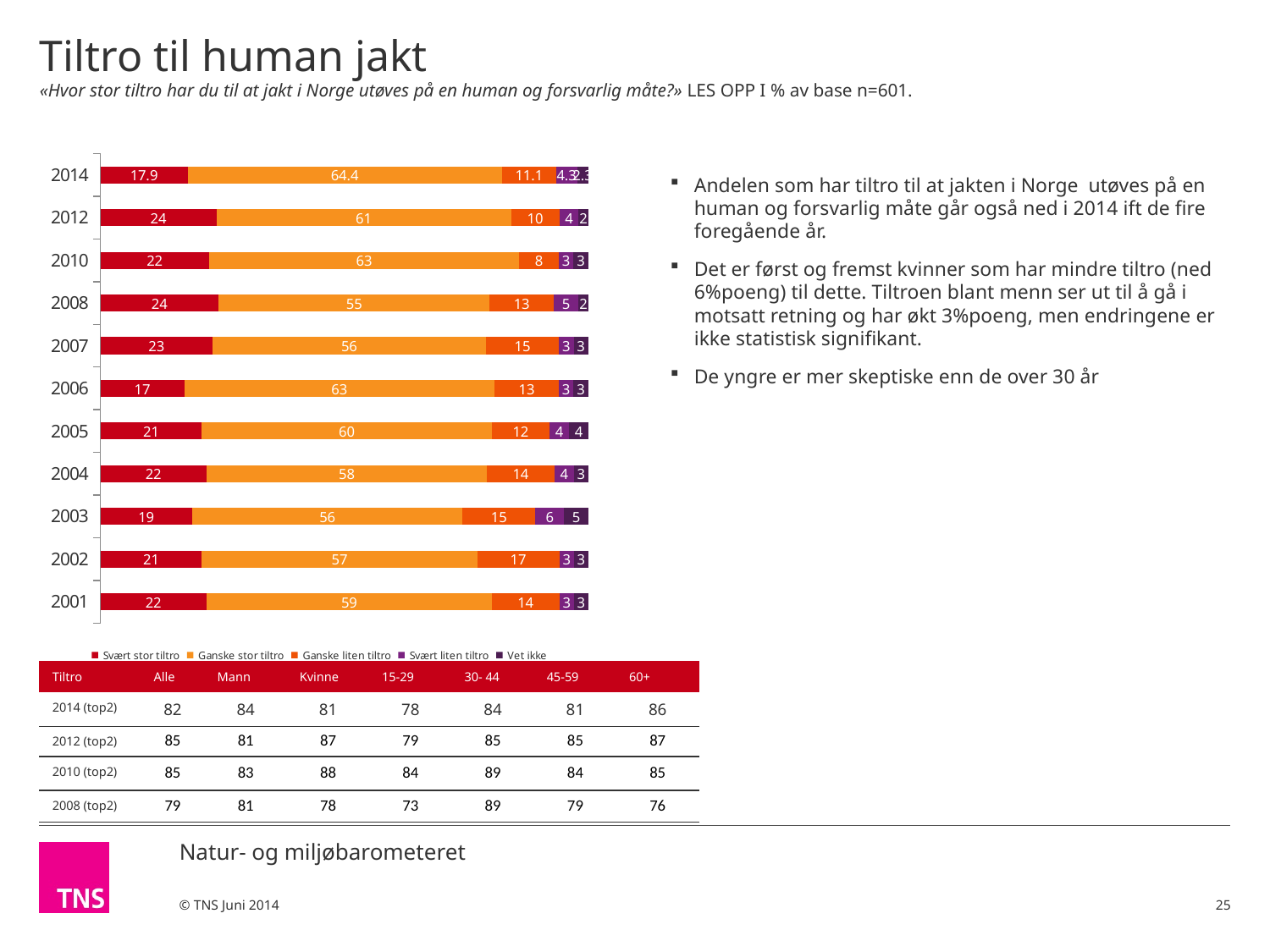
How many years (categories) are plotted in the chart? 11 Which series is shown in orange in the chart? Ganske stor tiltro In which year is the 'Ganske stor tiltro' value highest? 2014 What is the difference between the 'Ganske stor tiltro' values for 2010 and 2008? 8 What is the value for 'Ganske liten tiltro' in 2002? 17 What is the value for 'Vet ikke' in 2003? 5 Which is larger: the 'Ganske liten tiltro' value for 2007 or for 2010? 2007 How many series does the chart legend list? 5 What type of chart is shown on the slide? Stacked bar chart What is the value for 'Ganske stor tiltro' in 2014? 64.4 What is the value for 'Svært stor tiltro' in 2012? 24 In which year is the 'Svært stor tiltro' value lowest? 2006